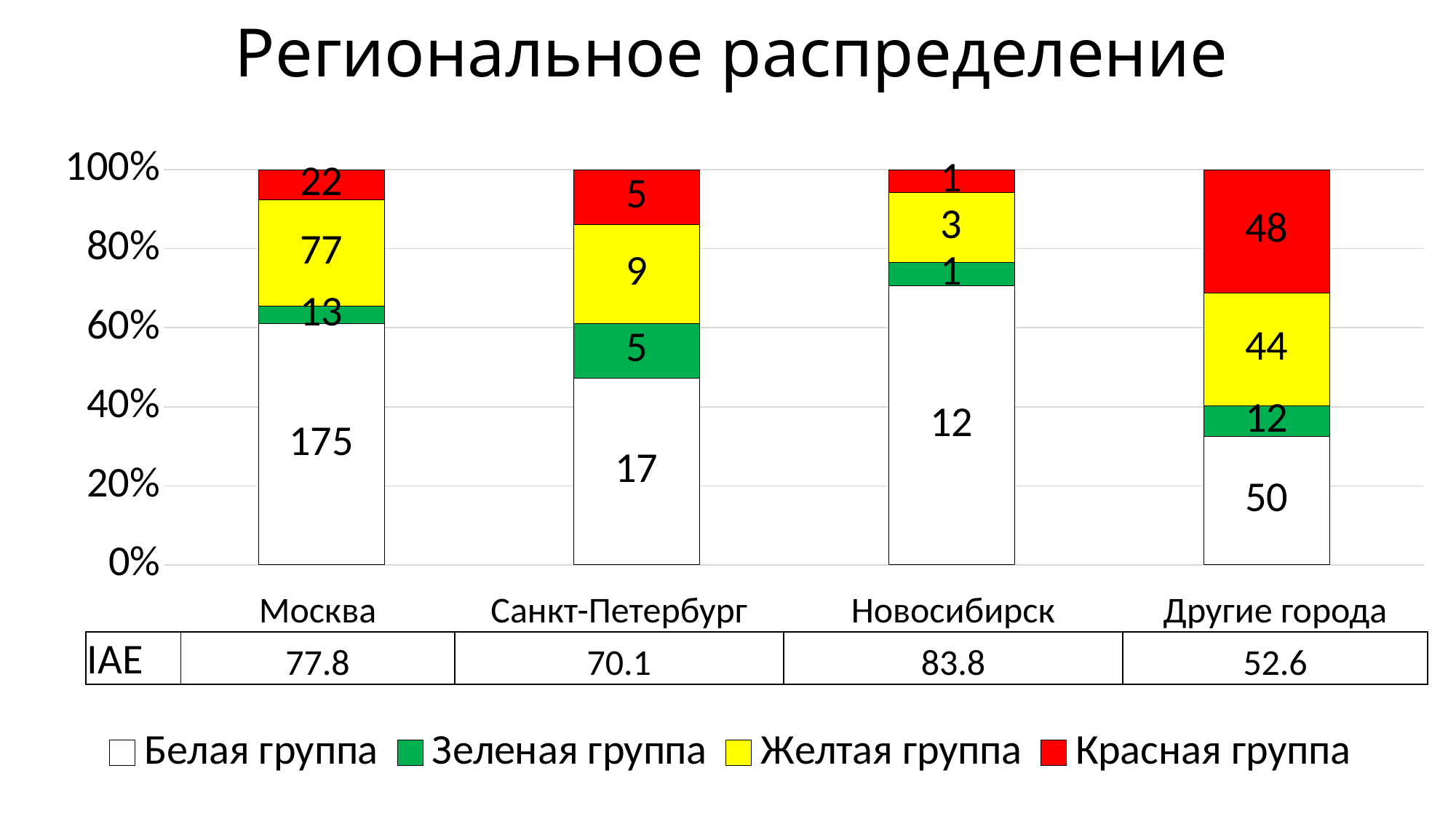
How many categories (cities) are shown on the x axis? 4 What type of chart is shown on the slide? stacked bar chart What is the value of Красная группа for Другие города? 48 What is the title of the chart? Региональное распределение What is the IAE value for Новосибирск? 83.8 How many series does the legend list? 4 What is the total of all four groups for Санкт-Петербург? 36 What is the value of Белая группа for Москва? 175 What is the difference between the Желтая группа values for Москва and Другие города? 33 Which is larger: the Красная группа value for Санкт-Петербург or for Новосибирск? Санкт-Петербург Which city has the lowest IAE value? Другие города Which city has the highest value for Желтая группа? Москва